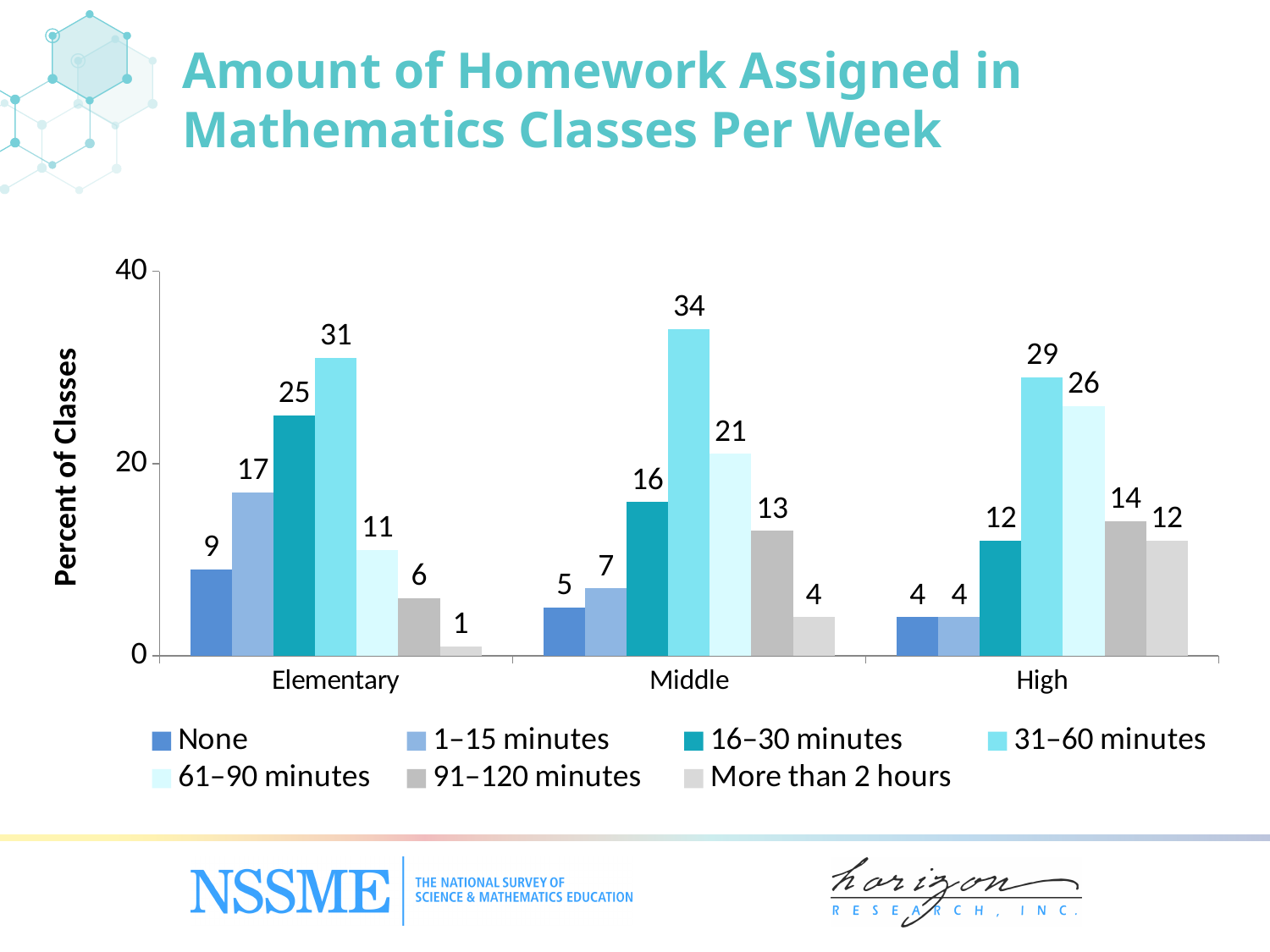
Which homework amount has the lowest percent of Elementary classes? More than 2 hours Is the value for Middle classes assigned 61–90 minutes greater or less than 20? greater How many grade-level categories are shown on the x axis? 3 Which is larger: the percent of High classes assigned 31–60 minutes or the percent assigned 61–90 minutes? 31–60 minutes Which homework amount has the highest percent of Middle classes? 31–60 minutes What is the difference between the percent of Middle classes and Elementary classes assigned 31–60 minutes? 3 What percent of Elementary classes are assigned 31–60 minutes of homework per week? 31 What percent of Middle classes are assigned 16–30 minutes of homework per week? 16 What percent of High classes are assigned more than 2 hours of homework per week? 12 How many series does the legend list? 7 What kind of chart is shown on the slide? Bar chart What is the label of the y axis? Percent of Classes